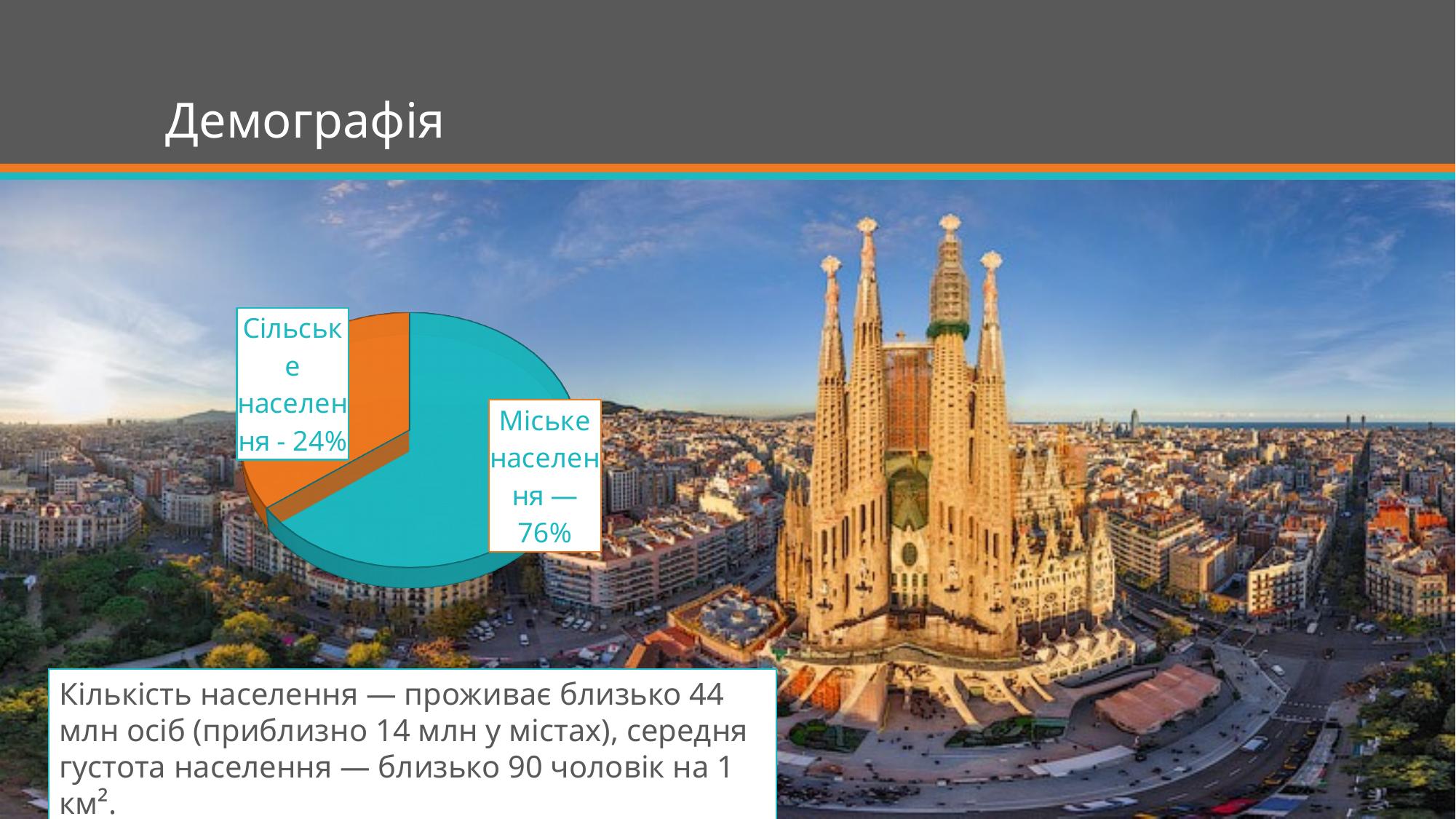
What kind of chart is shown on the slide? pie chart Which slice of the pie chart is the largest? Міське населення How many slices does the pie chart have? 2 Which slice of the pie chart is the smallest? Сільське населення What is the difference in percentage points between the urban (Міське населення) and rural (Сільське населення) slices? 52 Is the share for Сільське населення greater or less than 50%? less What colour is the slice for Сільське населення? orange What share of the pie does "Міське населення" (urban population) take? 76% Which is larger: the share for Міське населення or the share for Сільське населення? Міське населення What share of the pie does "Сільське населення" (rural population) take? 24% What colour is the slice for Міське населення? teal